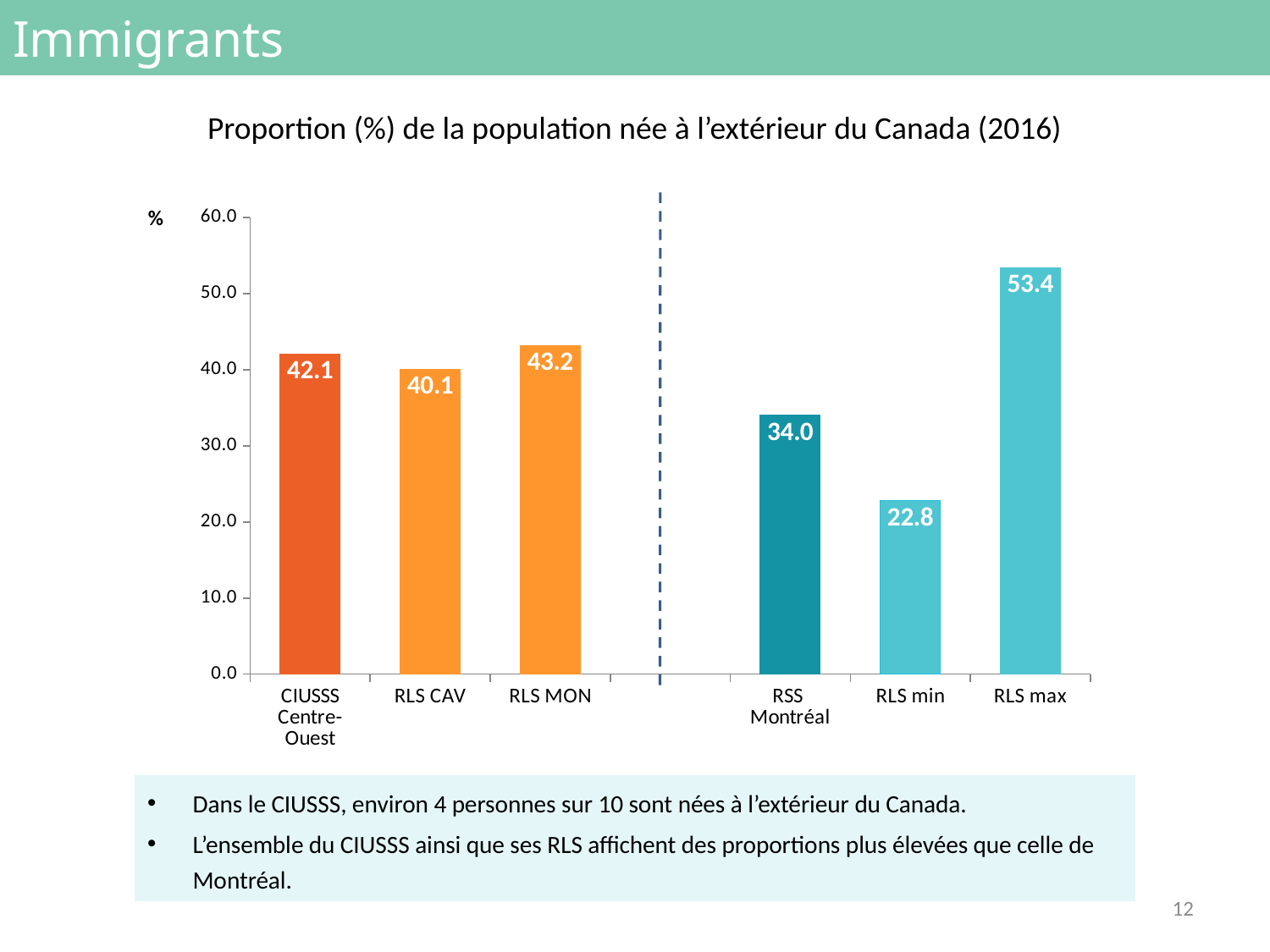
What is the value for RSS Montréal? 34.0 What is the value for CIUSSS Centre-Ouest? 42.1 Which category has the highest value? RLS max What is the difference between the values for RLS MON and RSS Montréal? 9.2 Which category has the lowest value? RLS min What is the title of the chart? Proportion (%) de la population née à l'extérieur du Canada (2016) What is the difference between the values for RLS max and RLS min? 30.6 Which is larger, the value for RLS MON or the value for RLS CAV? RLS MON What kind of chart is shown on the slide? bar chart How many categories are shown on the x axis? 6 Is the value for RSS Montréal greater or less than 40.0? less What is the value for RLS CAV? 40.1